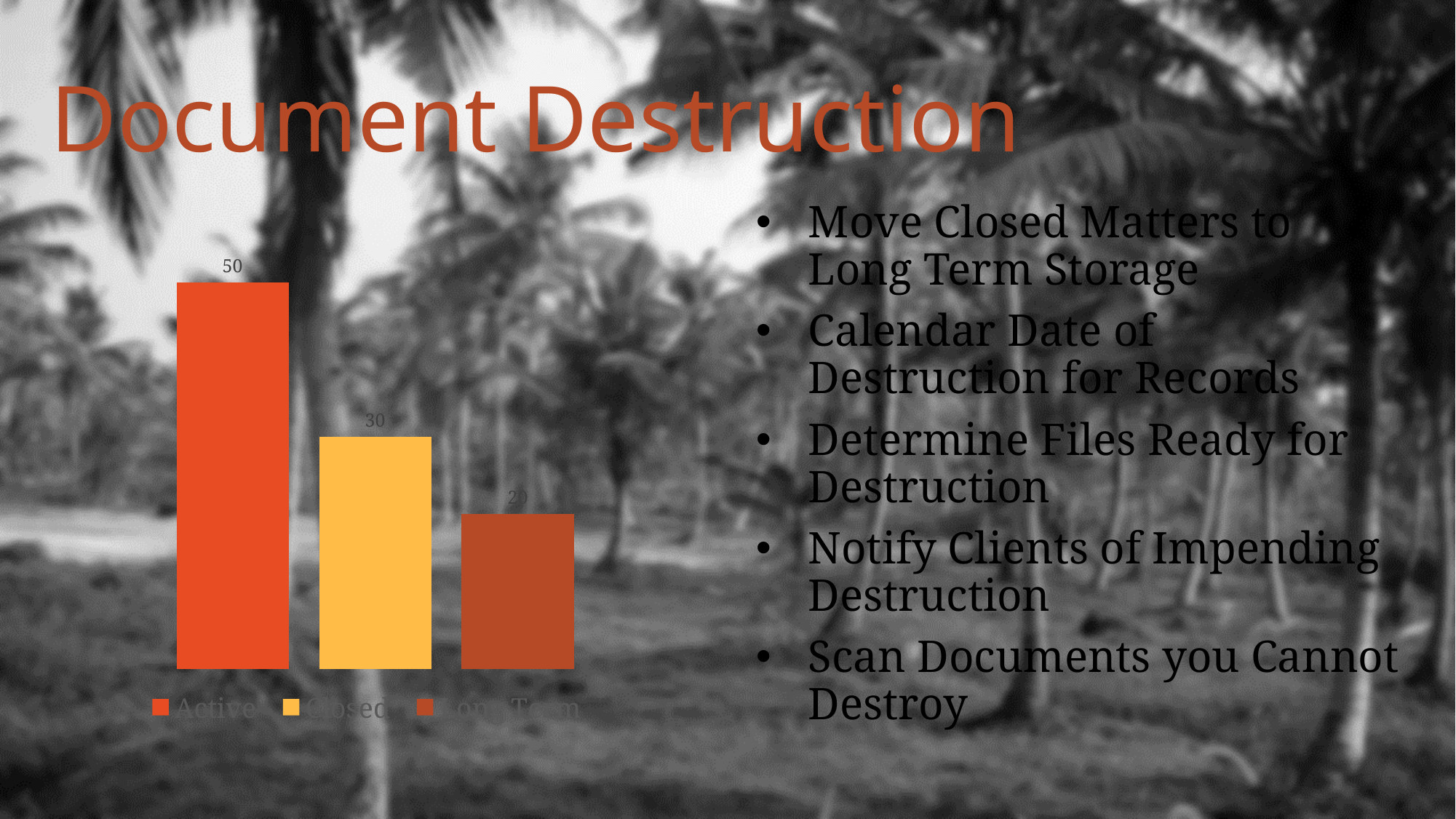
How many bars are plotted in the chart? 3 What is the difference between the values for Closed and Long Term? 10 What is the value for Active? 50 What is the value for Closed? 30 What colour is the Closed bar? yellow Which is larger, the value for Closed or the value for Long Term? Closed How many entries does the legend list? 3 Which category has the lowest value? Long Term What is the value for Long Term? 20 What is the difference between the values for Active and Closed? 20 Which category has the highest value? Active What kind of chart is shown on the slide? bar chart